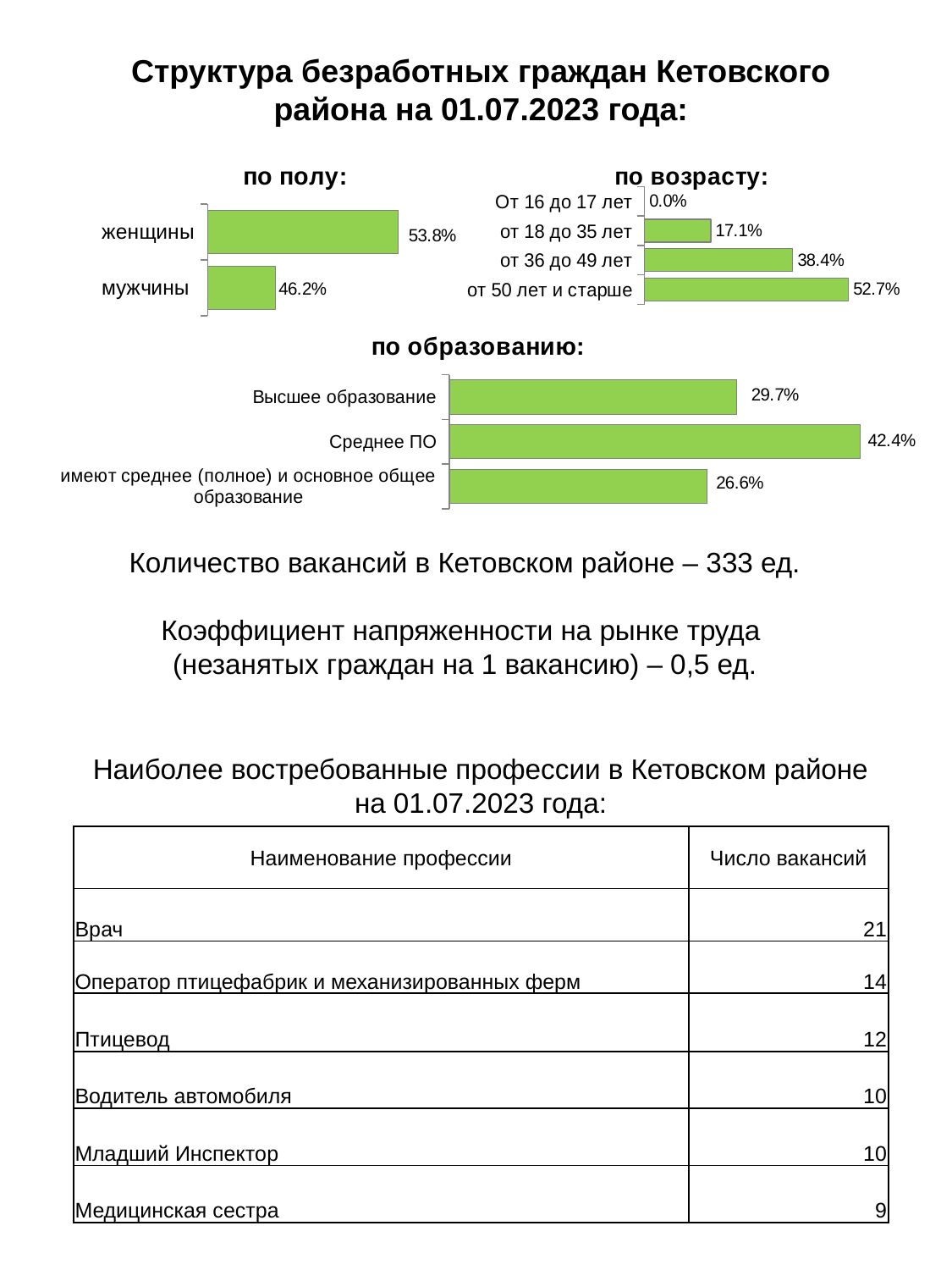
In the 'по возрасту' chart, what is the value for 'от 18 до 35 лет'? 17.1% In the 'по полу' chart, what is the value for женщины? 53.8% In the 'по возрасту' chart, how many age categories are shown? 4 In the 'по образованию' chart, which is larger: 'Высшее образование' or 'Среднее ПО'? Среднее ПО In the 'по образованию' chart, which category has the lowest value? имеют среднее (полное) и основное общее образование What kind of chart is the 'по образованию' chart? bar chart In the 'по полу' chart, how many categories are shown? 2 In the 'по образованию' chart, what is the value for 'Среднее ПО'? 42.4% In the 'по возрасту' chart, which age group has the highest value? от 50 лет и старше In the 'по возрасту' chart, which age group has the lowest value? От 16 до 17 лет In the 'по возрасту' chart, what is the difference between 'от 50 лет и старше' and 'от 36 до 49 лет'? 14.3% In the 'по полу' chart, what is the difference between женщины and мужчины? 7.6%